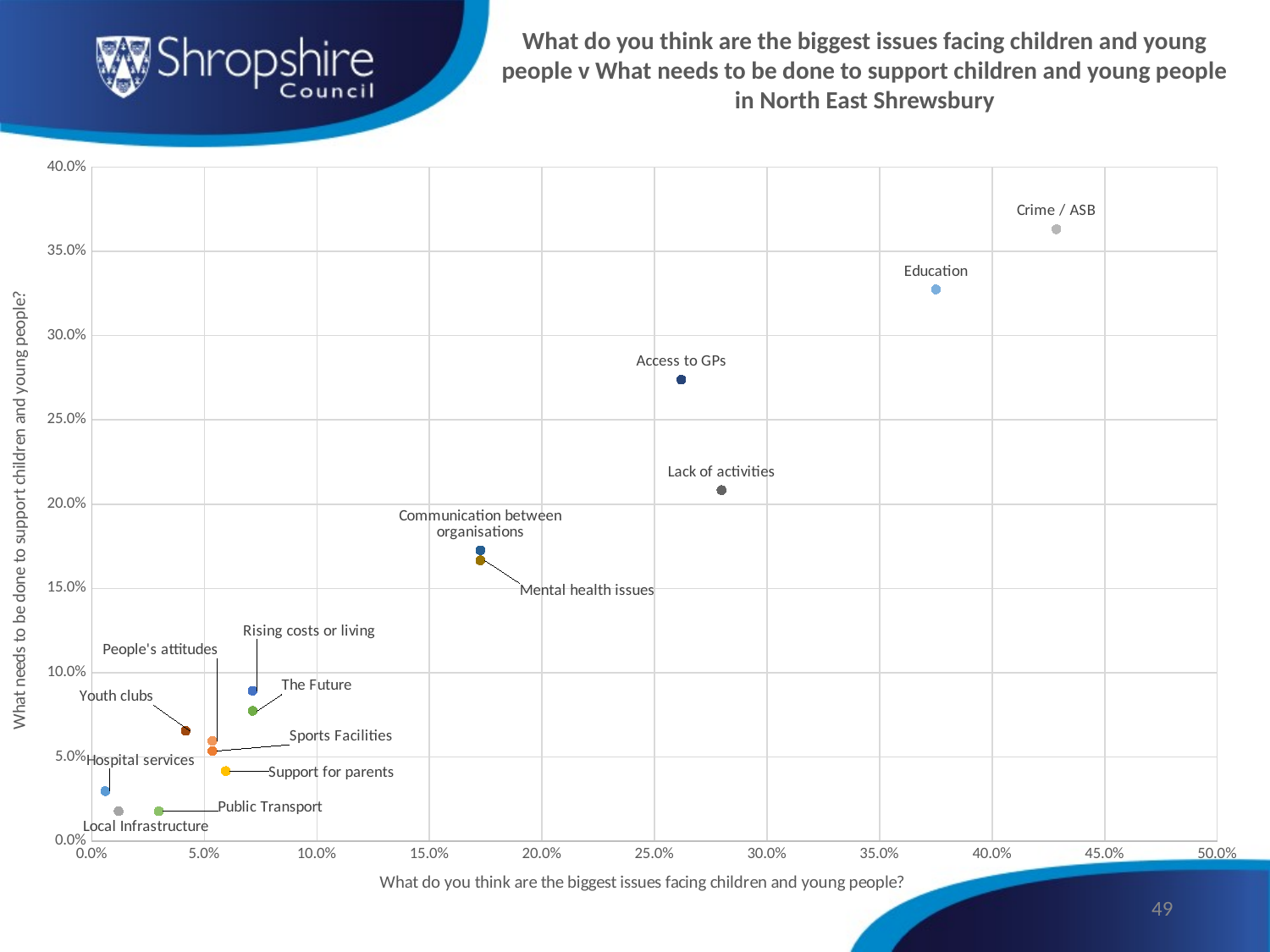
Is the horizontal-axis value for Crime / ASB greater or less than 40.0%? greater Which has the higher horizontal-axis value, Education or Crime / ASB? Crime / ASB Which issue has the highest value on the vertical axis (What needs to be done to support children and young people)? Crime / ASB What kind of chart is shown on the slide? Scatter chart Is the horizontal-axis value for Access to GPs greater or less than 30.0%? less Is the vertical-axis value for Lack of activities greater or less than 25.0%? less What is the title of the horizontal axis? What do you think are the biggest issues facing children and young people? How many labelled data points are plotted on the chart? 15 Which issue has the highest value on the horizontal axis (What do you think are the biggest issues facing children and young people)? Crime / ASB Which has the higher vertical-axis value, Access to GPs or Lack of activities? Access to GPs